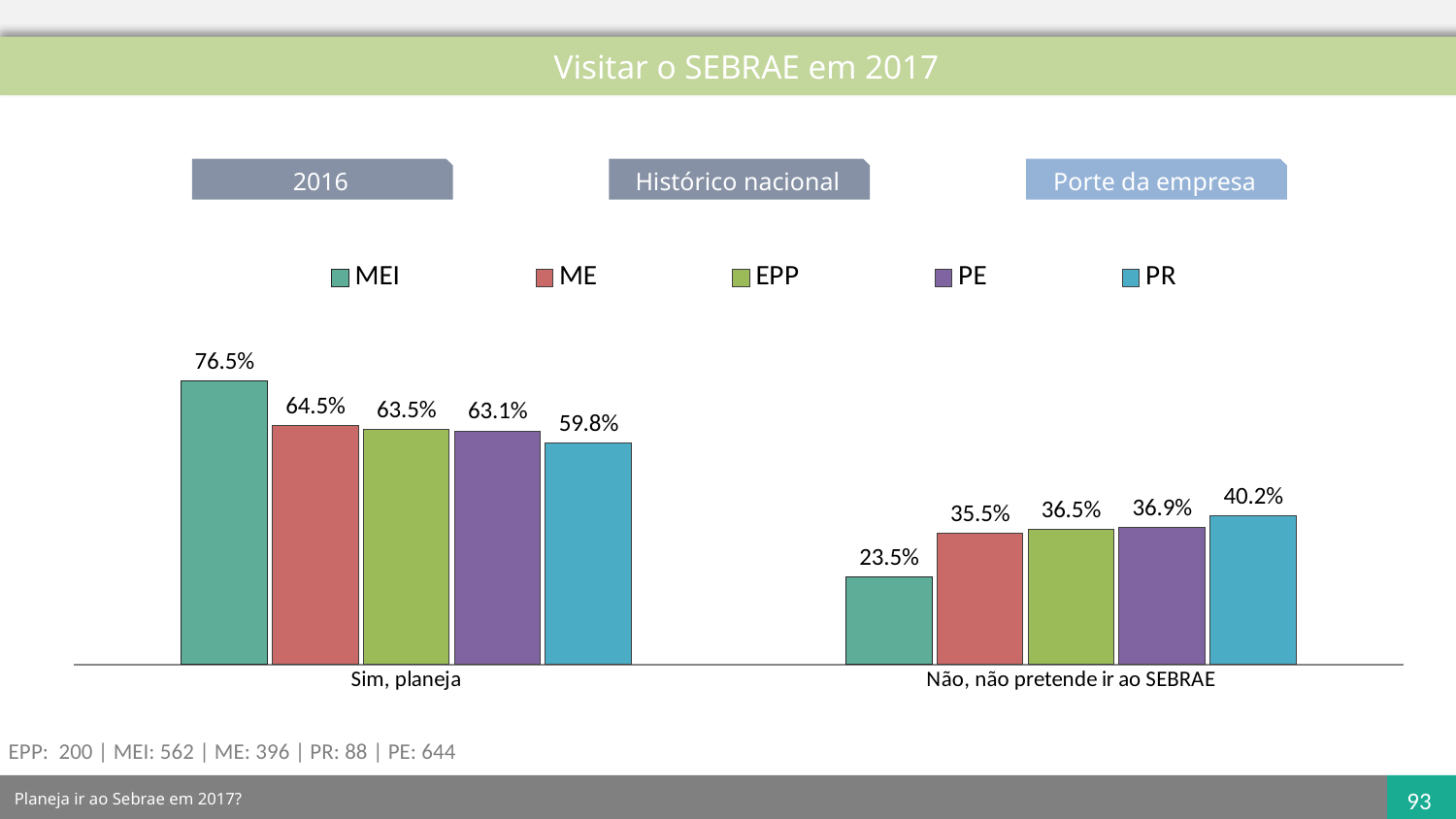
What colour are the bars for the PE series? Purple Which series has the highest value in the 'Sim, planeja' category? MEI Which series has the lowest value in the 'Não, não pretende ir ao SEBRAE' category? MEI Which is larger in the 'Não, não pretende ir ao SEBRAE' category: the value for EPP or the value for PR? PR What is the difference between the MEI and PR values in the 'Sim, planeja' category? 16.7% What is the value for MEI in the 'Sim, planeja' category? 76.5% What is the value for ME in the 'Não, não pretende ir ao SEBRAE' category? 35.5% What is the value for PR in the 'Não, não pretende ir ao SEBRAE' category? 40.2% What kind of chart is shown on the slide? Bar chart How many categories are shown on the x axis? 2 How many series does the legend list? 5 What is the title of the slide containing the chart? Visitar o SEBRAE em 2017